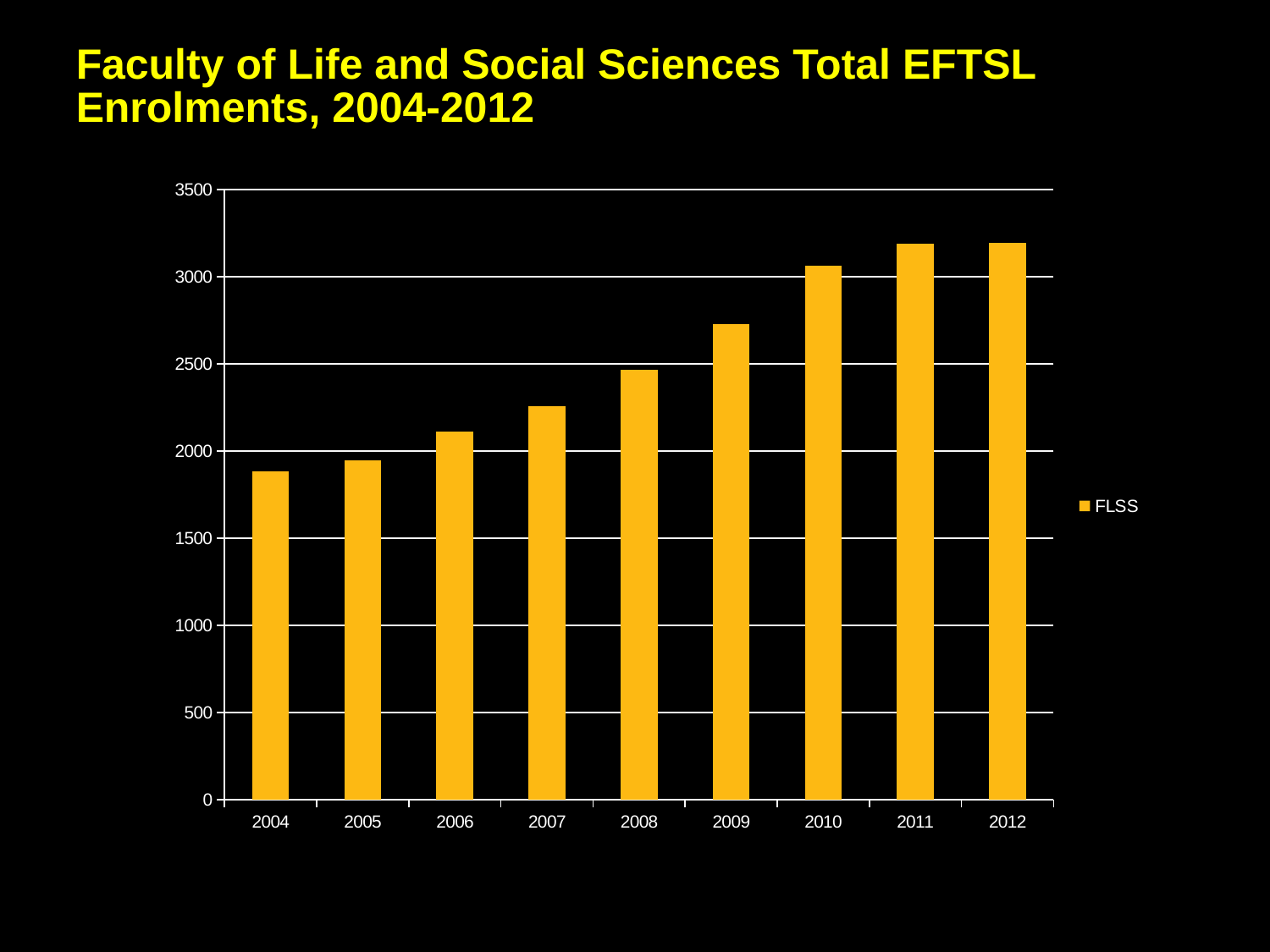
Is the value for 2009 greater or less than 2500? greater What kind of chart is shown on the slide? bar chart What is the name of the series shown in the legend? FLSS Do the enrolment values generally rise or fall from 2004 to 2012? rise How many years are shown on the x axis of the chart? 9 Is the value for 2004 greater or less than 2000? less Which year has the lowest EFTSL enrolments? 2004 Is the value for 2010 greater or less than 3000? greater Which is larger, the value for 2009 or the value for 2010? 2010 Which is larger, the value for 2006 or the value for 2008? 2008 How many series does the legend list? 1